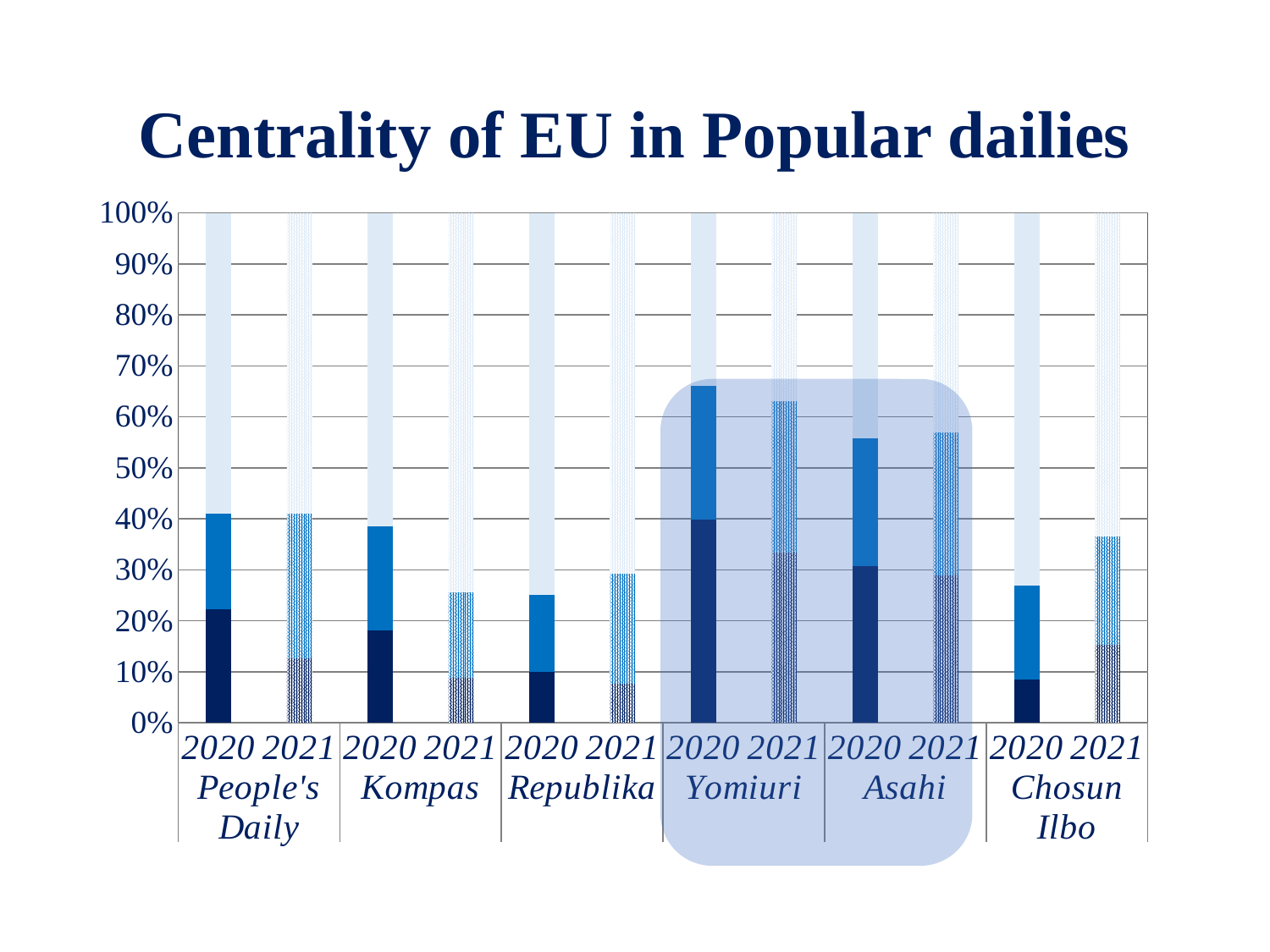
What is the title of the chart? Centrality of EU in Popular dailies How many bars are plotted in the chart in total? 12 Is the total value for Asahi 2021 greater or less than 50%? greater Which bar is taller for Kompas, 2020 or 2021? 2020 Which bar is taller for Chosun Ilbo, 2020 or 2021? 2021 How many newspapers are shown on the x axis of the chart? 6 Is the total value for Kompas 2021 greater or less than 30%? less Which two newspapers are highlighted with a shaded box on the chart? Yomiuri and Asahi Is the total value for Yomiuri 2020 greater or less than 60%? greater What kind of chart is shown on the slide? Stacked bar chart Which newspaper has the taller 2020 bar, Yomiuri or Asahi? Yomiuri